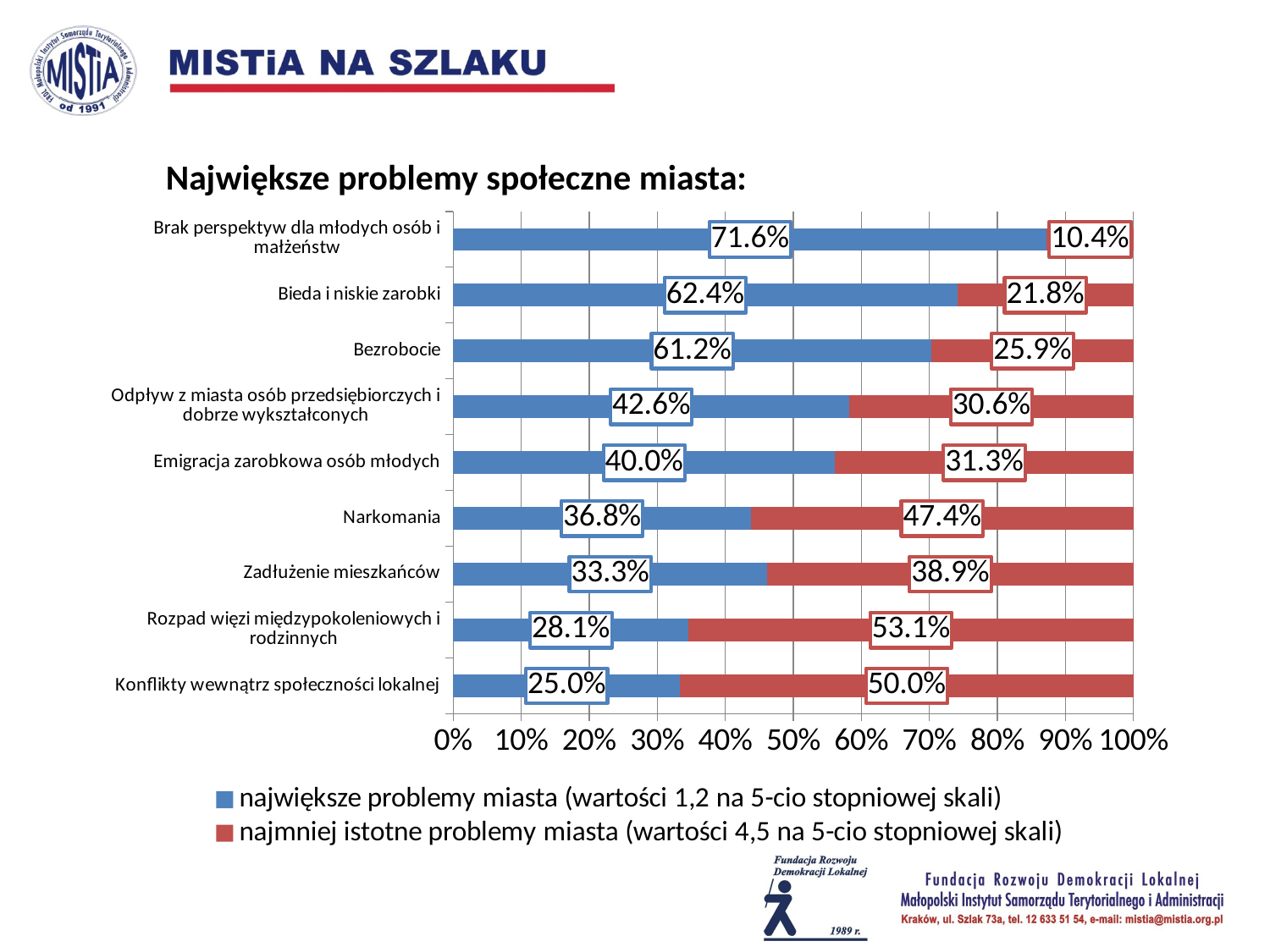
What is the value of the 'najmniej istotne problemy miasta' series for 'Narkomania'? 47.4% What is the difference between the 'największe problemy miasta' values for 'Bieda i niskie zarobki' and 'Bezrobocie'? 1.2% What is the value of the 'największe problemy miasta' series for 'Konflikty wewnątrz społeczności lokalnej'? 25.0% How many categories are shown on the chart? 9 How many series does the legend list? 2 Which category has the highest value in the 'największe problemy miasta' series? Brak perspektyw dla młodych osób i małżeństw Which is larger: the 'najmniej istotne problemy miasta' value for 'Zadłużenie mieszkańców' or for 'Emigracja zarobkowa osób młodych'? Zadłużenie mieszkańców What type of chart is shown on the slide? Stacked bar chart Which category has the highest value in the 'najmniej istotne problemy miasta' series? Rozpad więzi międzypokoleniowych i rodzinnych What is the value of the 'najmniej istotne problemy miasta' series for 'Brak perspektyw dla młodych osób i małżeństw'? 10.4% Which category has the lowest value in the 'najmniej istotne problemy miasta' series? Brak perspektyw dla młodych osób i małżeństw What is the value of the 'największe problemy miasta' series for 'Bezrobocie'? 61.2%